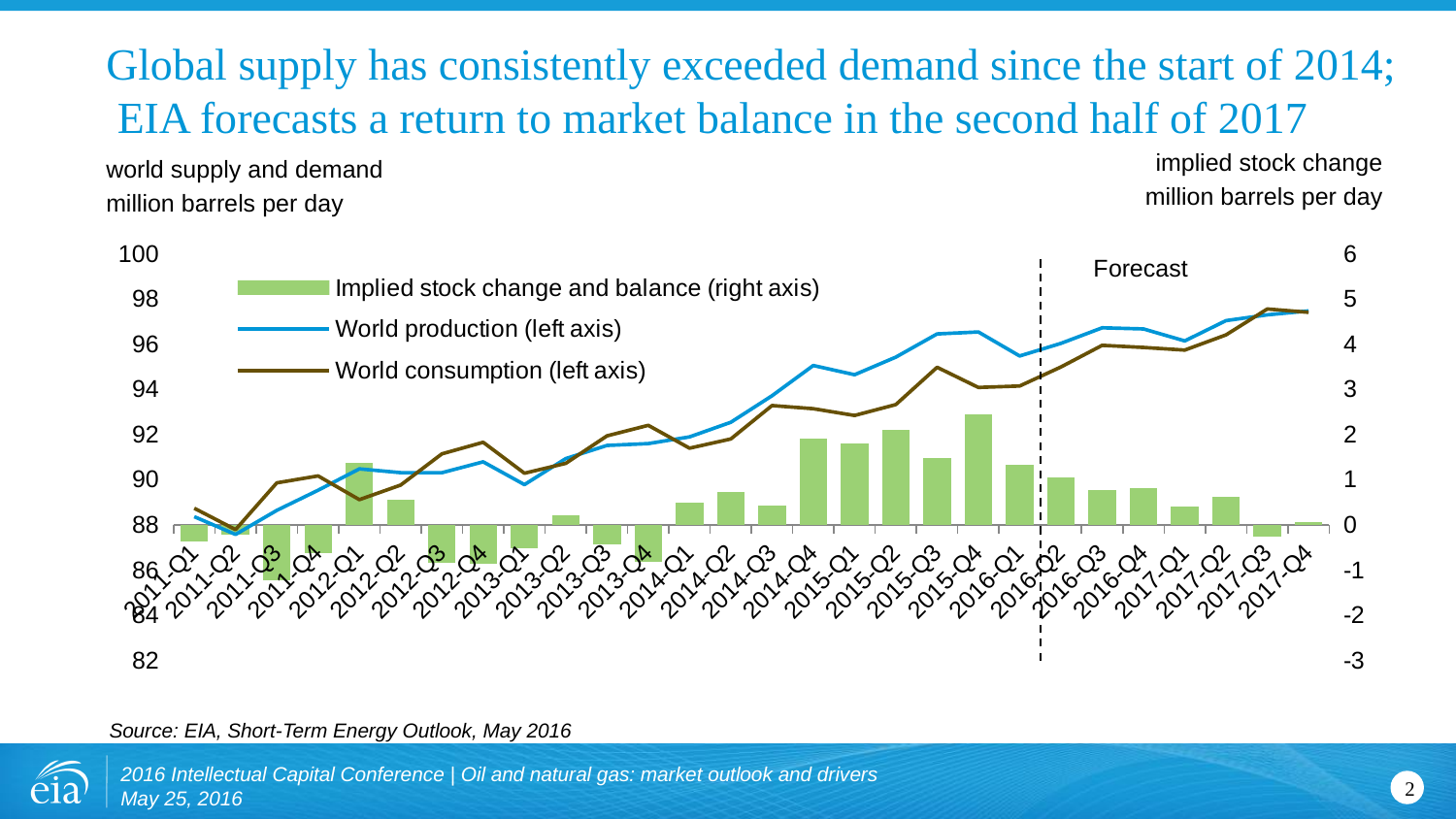
How many series does the legend list? 3 How many quarters are shown along the x axis? 28 Which quarter has the highest implied stock change bar? 2015-Q4 Which series is plotted on the right axis according to the legend? Implied stock change and balance In 2015-Q4, which is higher: world production or world consumption? World production Does the world production line generally rise or fall from 2011-Q1 to 2017-Q4? Rise What kind of chart is shown on the slide? A combination chart with bars and lines Is world production in 2011-Q1 greater or less than 90 million barrels per day? less Is the implied stock change for 2015-Q4 greater or less than 2 on the right axis? greater Is the implied stock change for 2015-Q3 greater or less than 2 on the right axis? less Which quarter has the lowest implied stock change bar? 2011-Q3